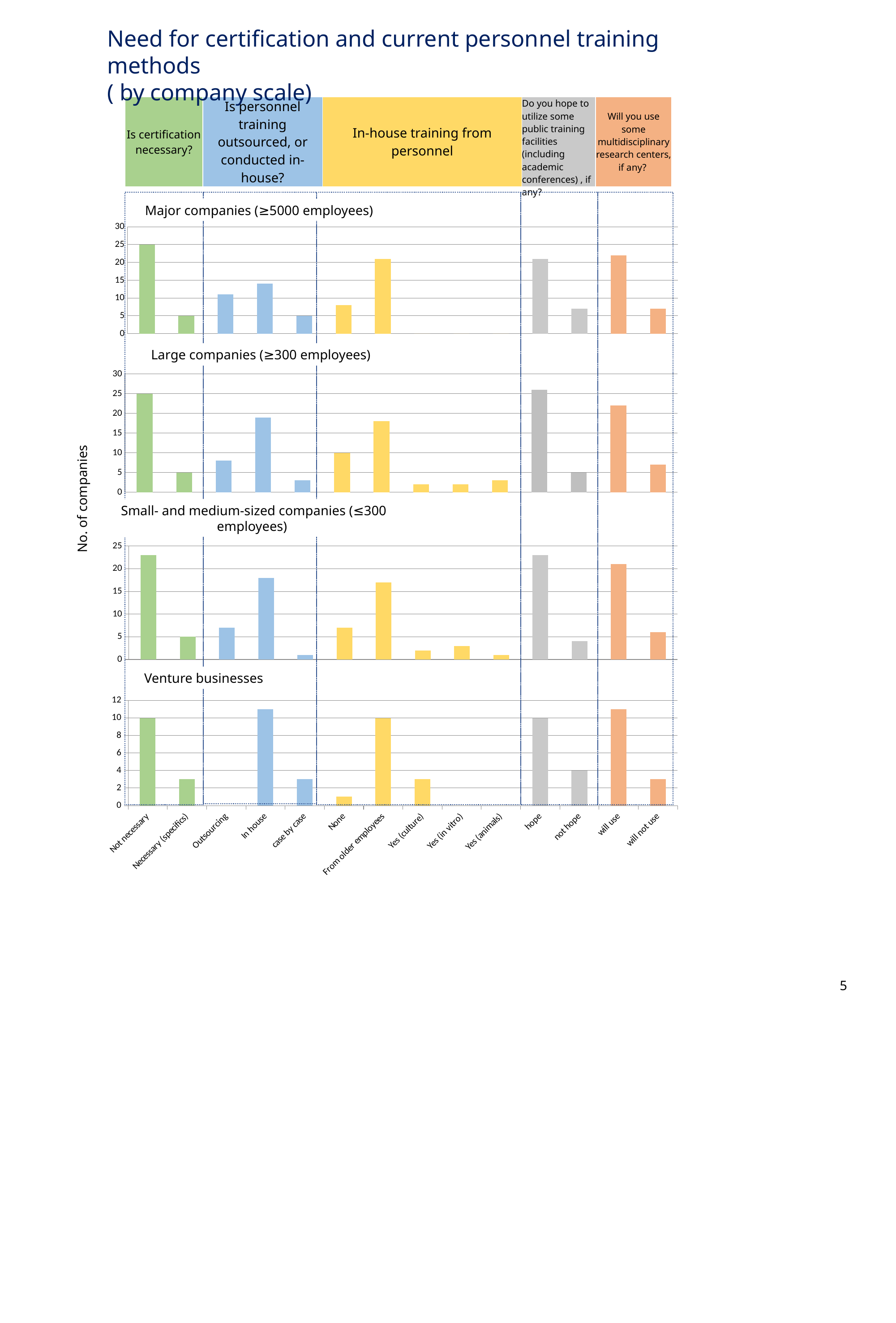
In the Large companies (≥300 employees) chart, is the value for In house greater or less than 15? greater In the Major companies (≥5000 employees) chart, which is larger, In house or Outsourcing? In house In the Venture businesses chart, what is the value for not hope? 4 What is the label on the shared vertical axis of the charts? No. of companies In the Major companies (≥5000 employees) chart, what is the difference between Not necessary and Necessary (specifics)? 20 In the Large companies (≥300 employees) chart, what is the value for None? 10 How many categories are listed along the shared x axis at the bottom of the charts? 14 What kind of chart is used for the Major companies (≥5000 employees) panel? bar chart In the Major companies (≥5000 employees) chart, which category has the highest value? Not necessary In the Major companies (≥5000 employees) chart, what is the value for Not necessary? 25 In the Venture businesses chart, what is the value for hope? 10 In the Venture businesses chart, is the value for will not use greater or less than 4? less